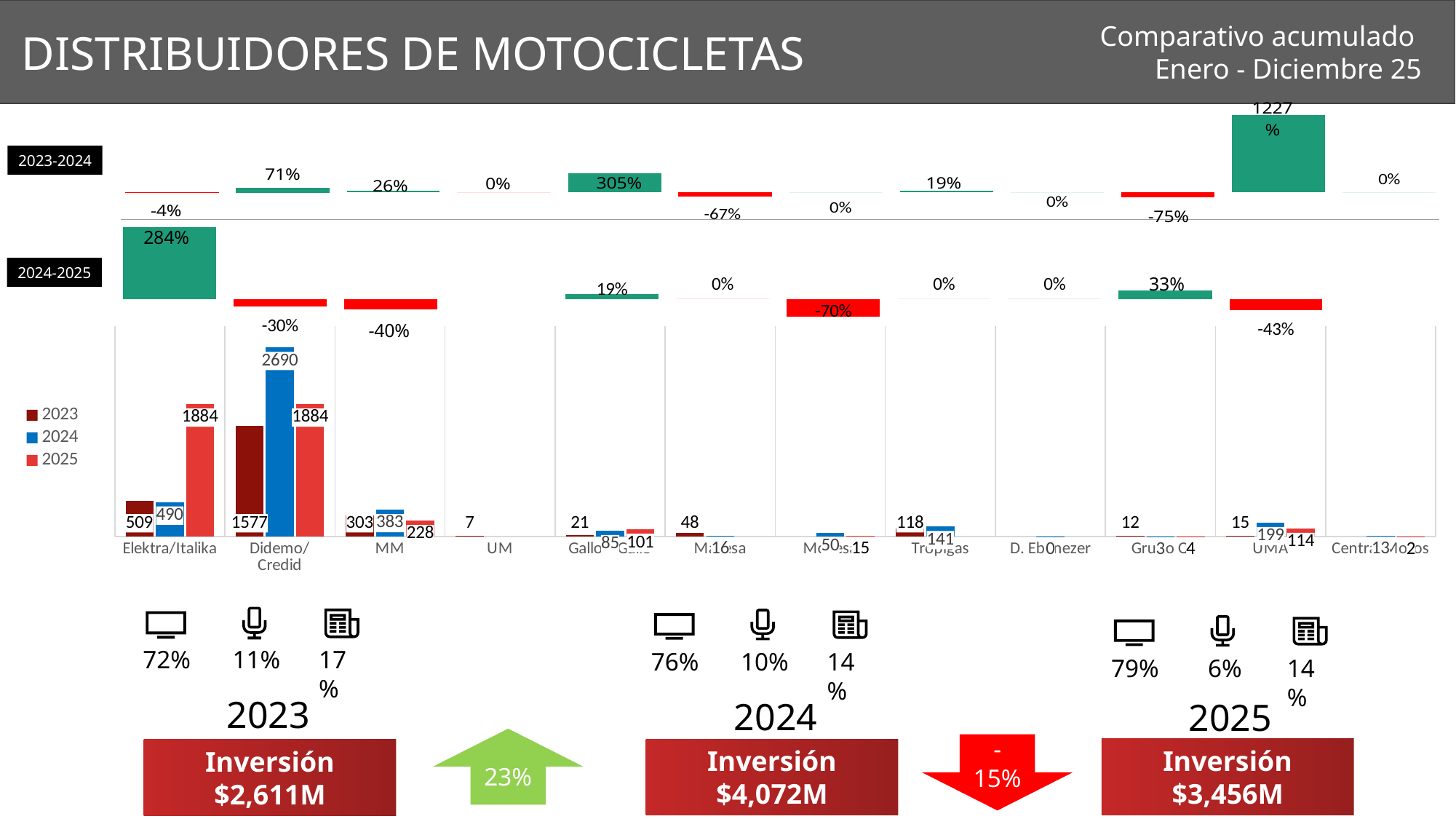
In the bottom bar chart, which distributor has the highest 2024 value? Didemo/Credid In the 2024-2025 chart, what is the value shown for Elektra/Italika? 284% In the bottom bar chart, which is larger for Elektra/Italika: the 2024 value or the 2025 value? 2025 In the 2023-2024 chart at the top, which distributor has the highest value? UMA In the bottom bar chart, what is the 2023 value for MM? 303 In the bottom bar chart, what is the difference between the 2024 and 2023 values for Didemo/Credid? 1113 In the 2023-2024 chart at the top, what is the value shown for UMA? 1227% In the bottom bar chart, what is the 2025 value for Elektra/Italika? 1884 In the bottom bar chart, what is the 2024 value for UMA? 199 How many series does the legend of the bottom chart list? 3 What kind of chart is the bottom chart with the 2023, 2024 and 2025 series? Bar chart In the bottom bar chart, what is the 2024 value for Didemo/Credid? 2690